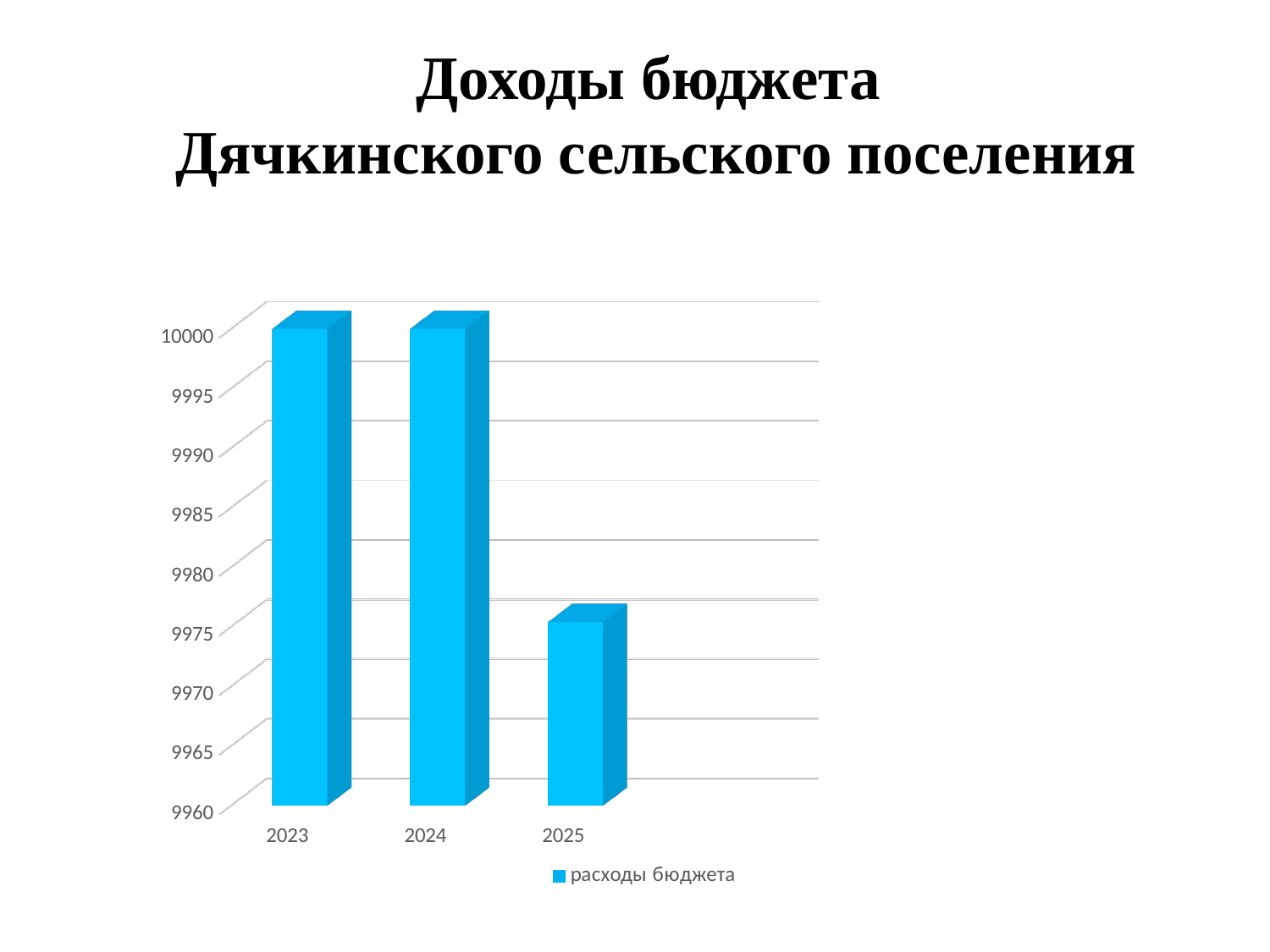
Is the value for 2025 greater or less than 9980? less Do the values rise or fall from 2023 to 2025? fall What series name is shown in the chart legend? расходы бюджета Is the value for 2023 greater or less than 9990? greater What is the title of the slide? Доходы бюджета Дячкинского сельского поселения Is the value for 2024 greater or less than 9985? greater What kind of chart is shown on the slide? bar chart How many series does the chart legend list? 1 Which year has the lowest value in the chart? 2025 Which is larger, the value for 2024 or the value for 2025? 2024 How many years are shown on the x axis of the chart? 3